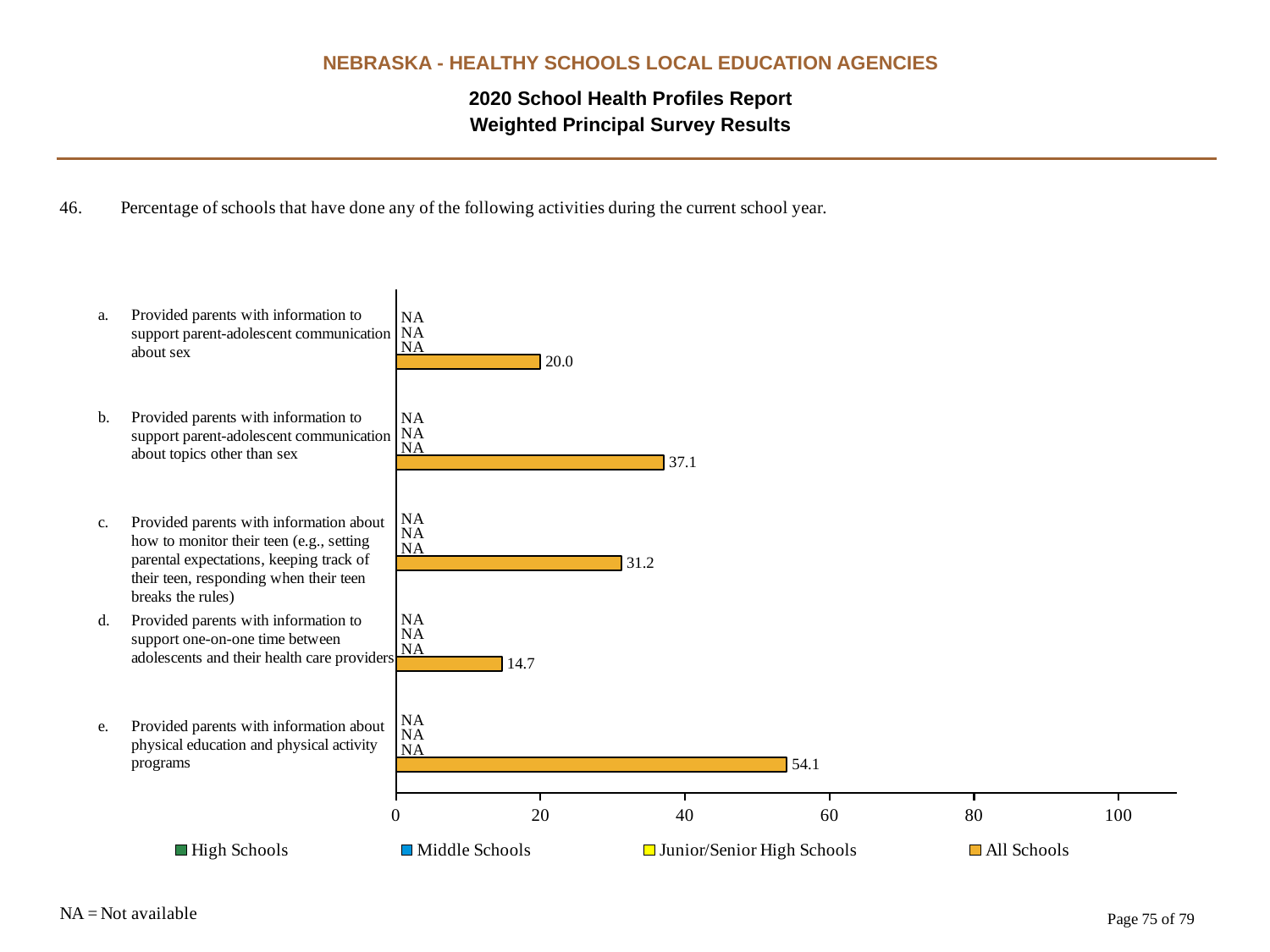
How many series does the legend list? 4 What value is shown for High Schools, Middle Schools and Junior/Senior High Schools for every activity? NA Is the All Schools value for item e greater or less than 40? greater Which activity has the highest All Schools percentage? e. Provided parents with information about physical education and physical activity programs What is the difference between the All Schools values for item b (37.1) and item c (31.2)? 5.9 What kind of chart is shown on the slide? Bar chart What is the All Schools value for item a, providing parents with information to support parent-adolescent communication about sex? 20.0 Which activity has the lowest All Schools percentage? d. Provided parents with information to support one-on-one time between adolescents and their health care providers How many activities (categories) are shown on the chart? 5 What is the All Schools value for item e, providing parents with information about physical education and physical activity programs? 54.1 What is the All Schools value for item d, providing parents with information to support one-on-one time between adolescents and their health care providers? 14.7 Which is larger for All Schools: item b (communication about topics other than sex) or item a (communication about sex)? Item b